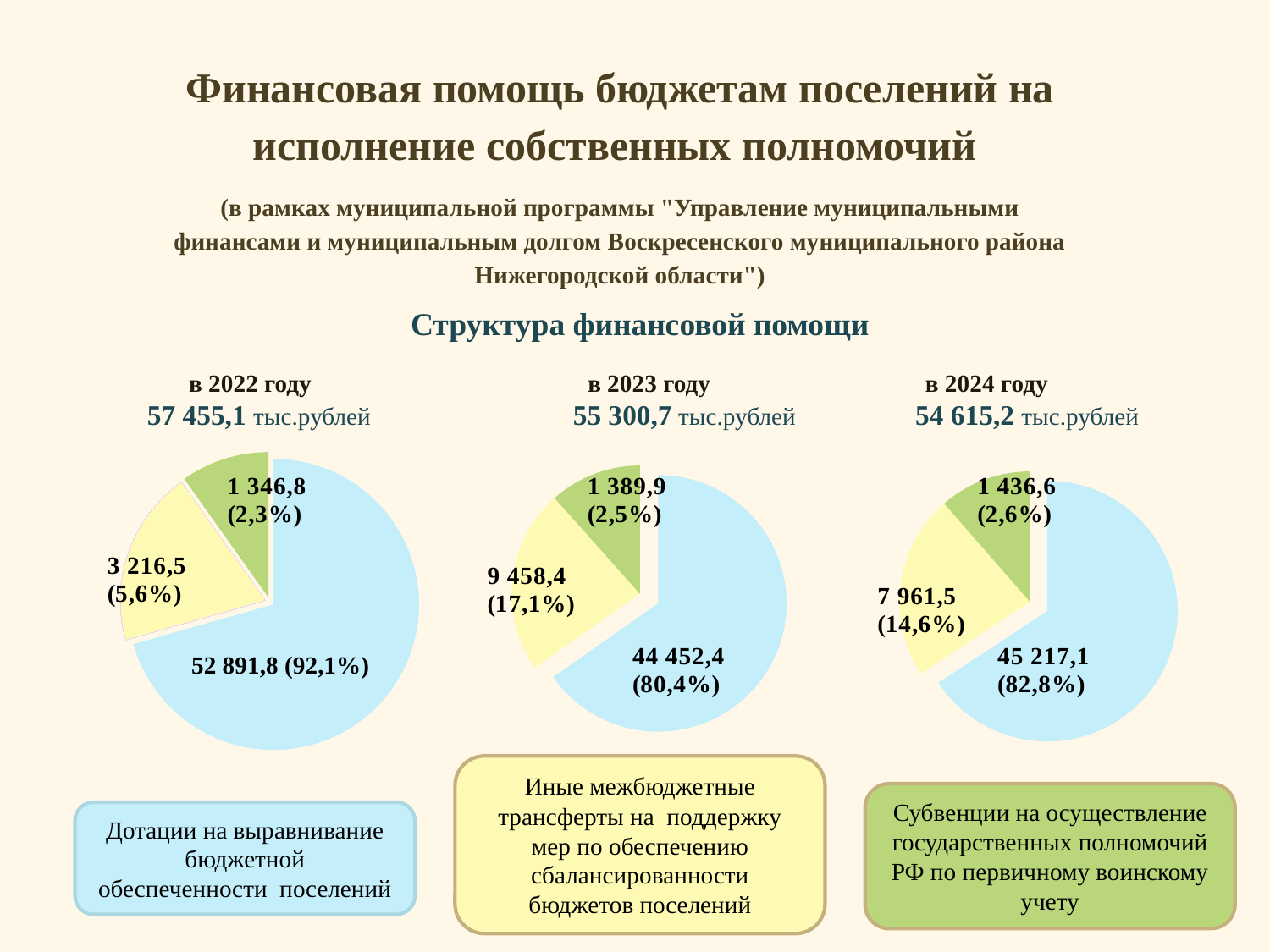
What is the total financial aid shown for the 2024 pie chart (в 2024 году)? 54 615,2 тыс.рублей In the pie chart for 2023 (в 2023 году), what share of the total is Иные межбюджетные трансферты? 17,1% What kind of chart is used to show the structure of financial aid for each year? Pie chart In the pie chart for 2024 (в 2024 году), what is the value for Субвенции на осуществление государственных полномочий РФ по первичному воинскому учету? 1 436,6 What colour represents Субвенции на осуществление государственных полномочий РФ по первичному воинскому учету in the pie charts? Green In the pie chart for 2022 (в 2022 году), what is the value for Дотации на выравнивание бюджетной обеспеченности поселений? 52 891,8 In the pie chart for 2023 (в 2023 году), which category has the largest slice? Дотации на выравнивание бюджетной обеспеченности поселений Across the three pie charts from 2022 to 2024, does the value for Субвенции rise or fall? Rises How many slices does the pie chart for 2022 (в 2022 году) have? 3 Which year has the larger value for Иные межбюджетные трансферты: 2023 or 2024? 2023 In the pie chart for 2022 (в 2022 году), what is the difference between the value for Иные межбюджетные трансферты and the value for Субвенции? 1 869,7 In the pie chart for 2024 (в 2024 году), which category has the smallest slice? Субвенции на осуществление государственных полномочий РФ по первичному воинскому учету